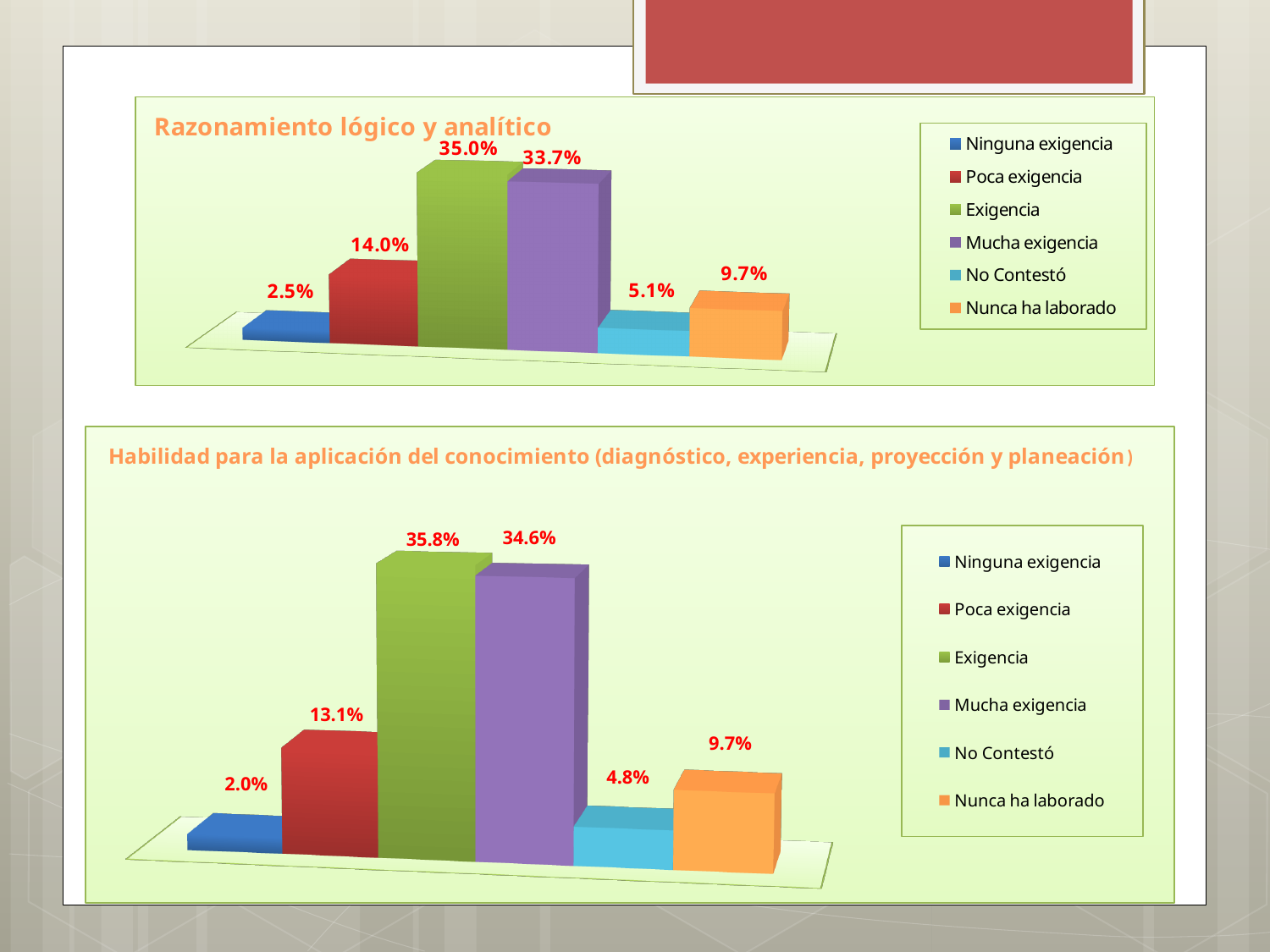
In the 'Razonamiento lógico y analítico' chart, what is the value for Poca exigencia? 14.0% In the 'Razonamiento lógico y analítico' chart, how many series does the legend list? 6 What kind of chart is the 'Habilidad para la aplicación del conocimiento' chart? Bar chart In the 'Razonamiento lógico y analítico' chart, what is the value for Exigencia? 35.0% In the 'Habilidad para la aplicación del conocimiento' chart, which is larger: Poca exigencia or Nunca ha laborado? Poca exigencia In the 'Razonamiento lógico y analítico' chart, which category has the lowest value? Ninguna exigencia In the 'Habilidad para la aplicación del conocimiento' chart, what is the value for Mucha exigencia? 34.6% In the 'Habilidad para la aplicación del conocimiento' chart, what is the difference between Poca exigencia and Ninguna exigencia? 11.1% In the 'Razonamiento lógico y analítico' chart, what is the difference between Exigencia and Mucha exigencia? 1.3% In the 'Razonamiento lógico y analítico' chart, what colour is the bar for Nunca ha laborado? Orange In the 'Habilidad para la aplicación del conocimiento' chart, which category has the highest value? Exigencia In the 'Habilidad para la aplicación del conocimiento' chart, what is the value for No Contestó? 4.8%